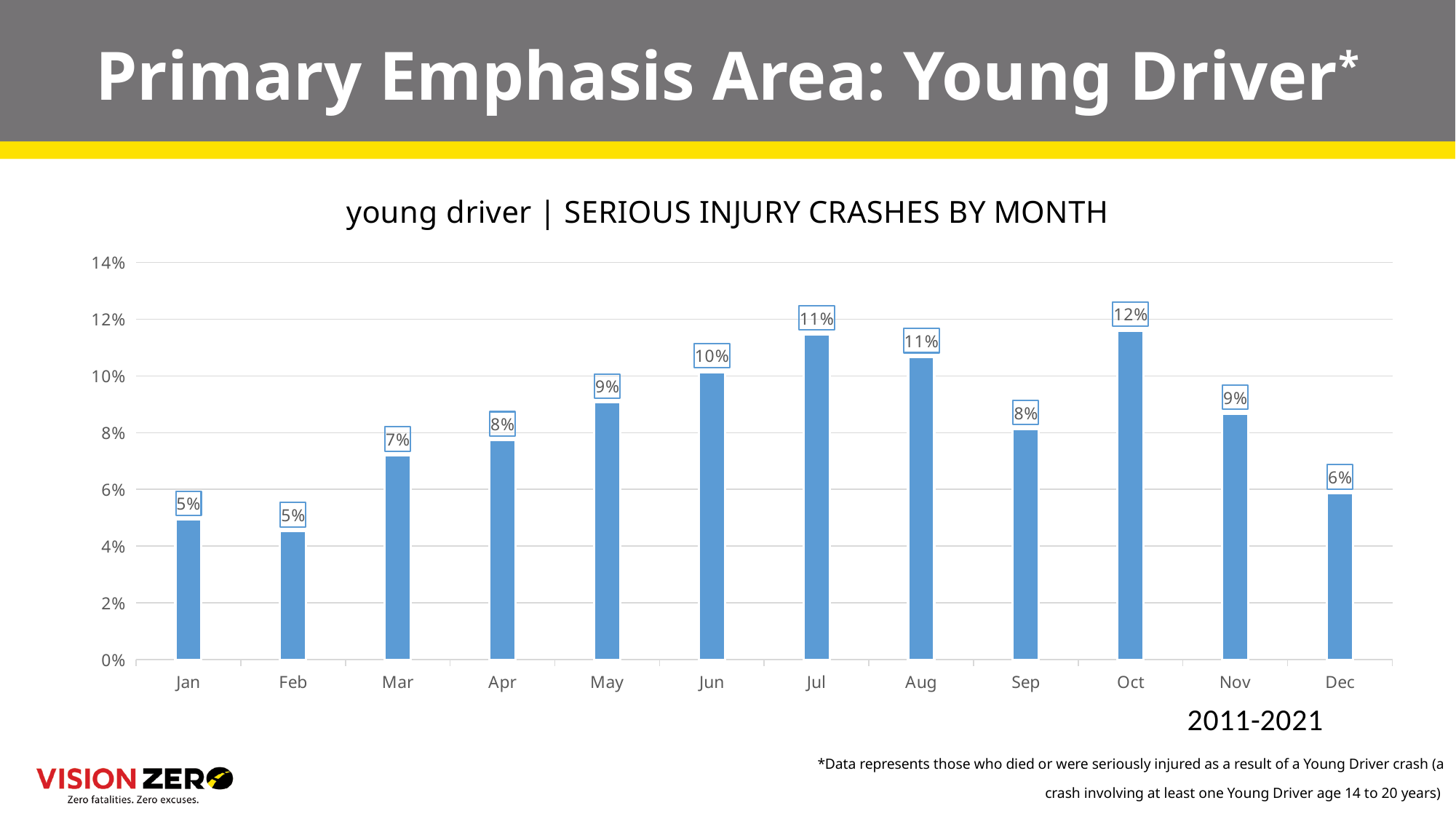
How many months are shown on the x axis? 12 What is the value for Oct? 12% Which is larger, the value for Jun or the value for Sep? Jun What is the value for Mar? 7% What is the difference between the values for Oct and Dec? 6% Is the value for Jul greater or less than 10%? greater What year range is shown below the chart? 2011-2021 What is the difference between the values for Jul and Mar? 4% Do the values rise or fall from Jan to Jul? rise What is the value for Dec? 6% Which month has the highest value? Oct What kind of chart is shown on the slide? bar chart